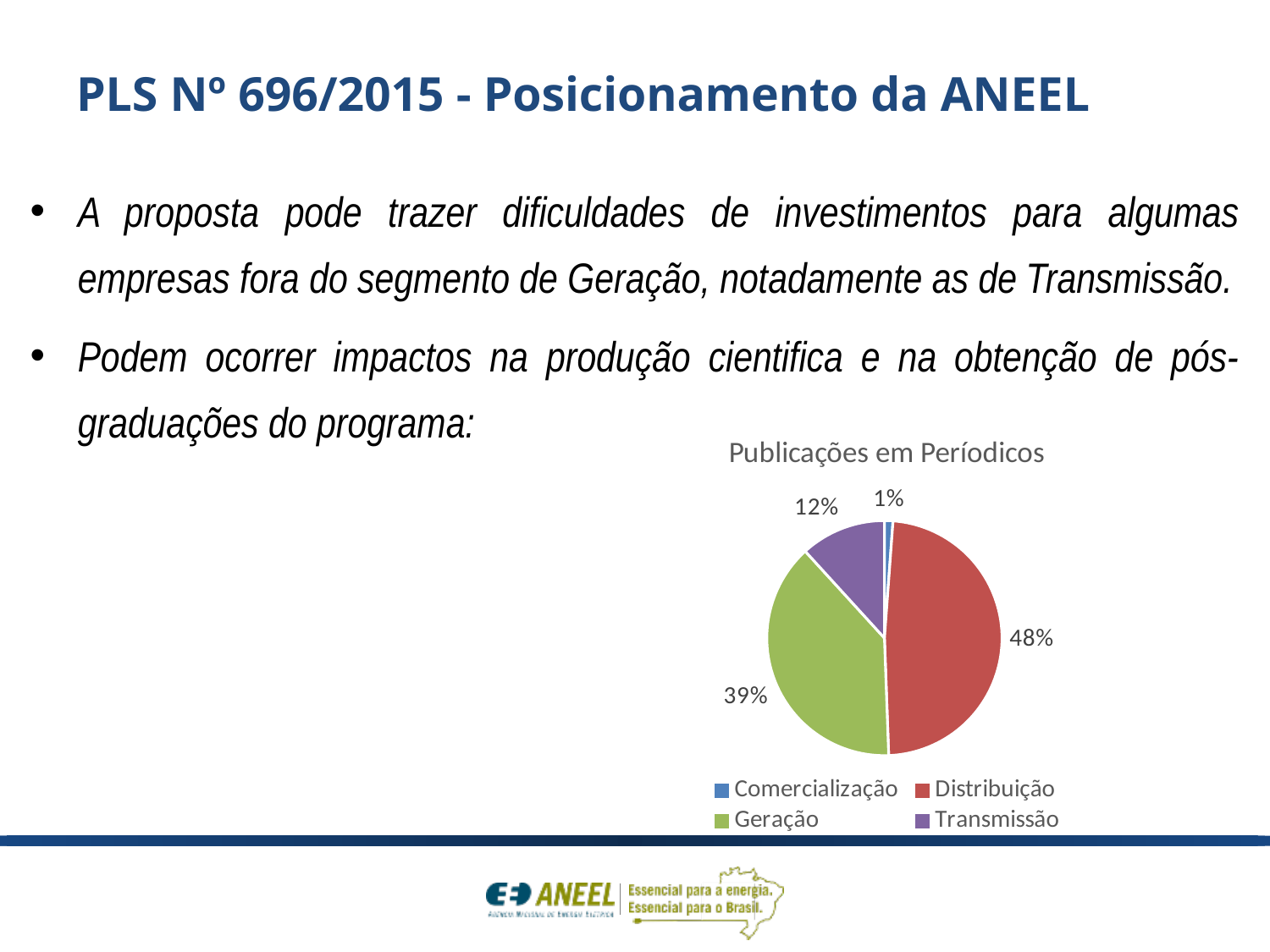
Which colour represents Geração in the legend? green What share of the pie does Comercialização have? 1% What share of the pie does Transmissão have? 12% What is the difference in percentage points between Distribuição and Geração? 9 What share of the pie does Geração have? 39% Which is larger, the share for Geração or the share for Transmissão? Geração Which category has the largest slice of the pie? Distribuição What is the title of the chart? Publicações em Períodicos Which category has the smallest slice of the pie? Comercialização How many categories does the pie chart have? 4 What kind of chart is shown on the slide? pie chart What share of the pie does Distribuição have? 48%